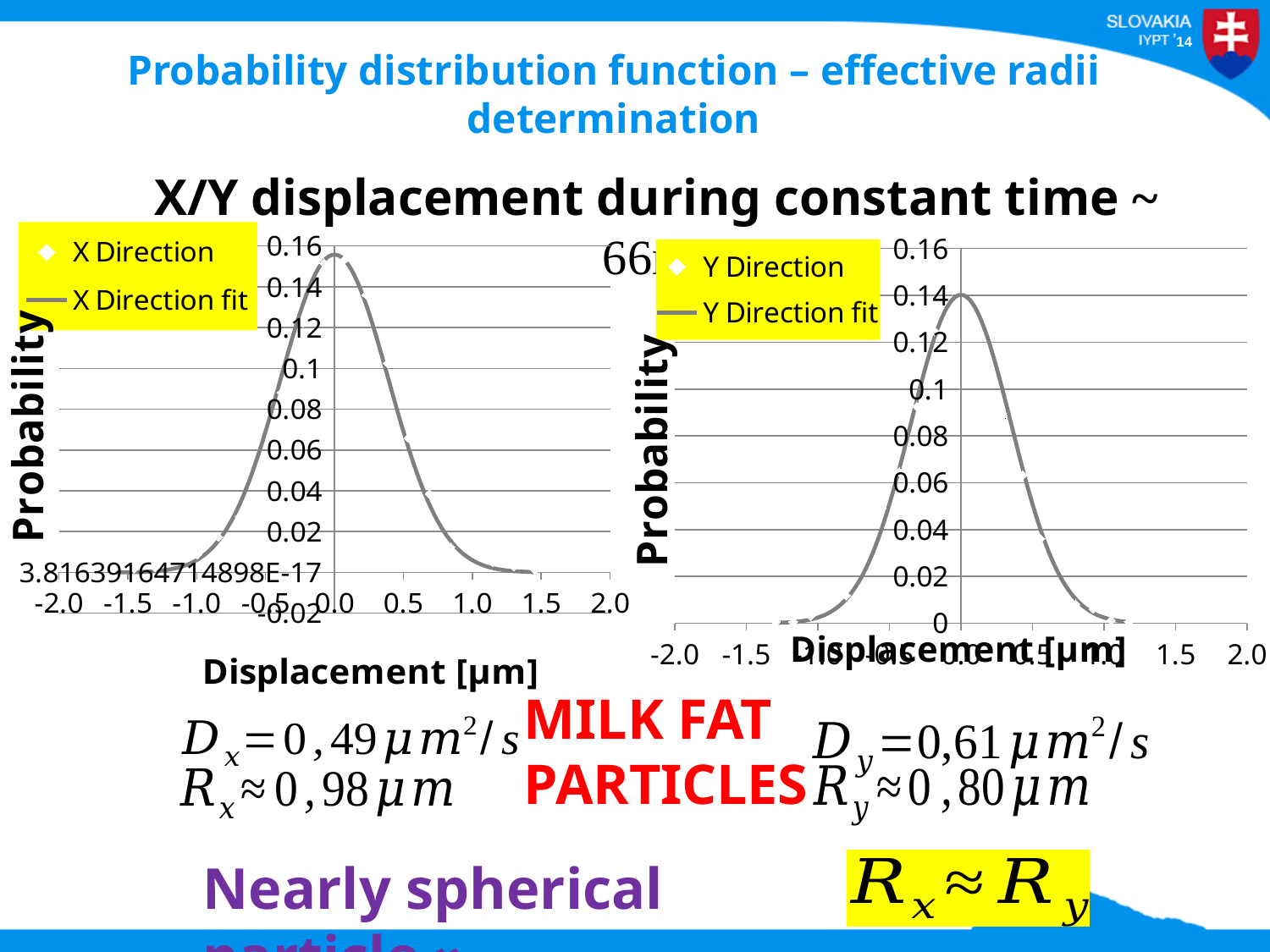
What are the two legend entries of the left chart? X Direction, X Direction fit What are the two legend entries of the right chart? Y Direction, Y Direction fit How many series does the legend of the right chart list? 2 What is the highest tick value shown on the y axis of the left chart? 0.16 In the right chart, is the peak value of the Y Direction fit curve greater or less than 0.12? greater In the right chart, does the Y Direction fit curve rise or fall as displacement increases from 0.0 to 1.0 μm? fall How many series does the legend of the left chart list? 2 In the left chart, is the peak value of the X Direction fit curve greater or less than 0.14? greater In the right chart, is the value of the Y Direction fit at a displacement of -1.0 μm greater or less than 0.04? less